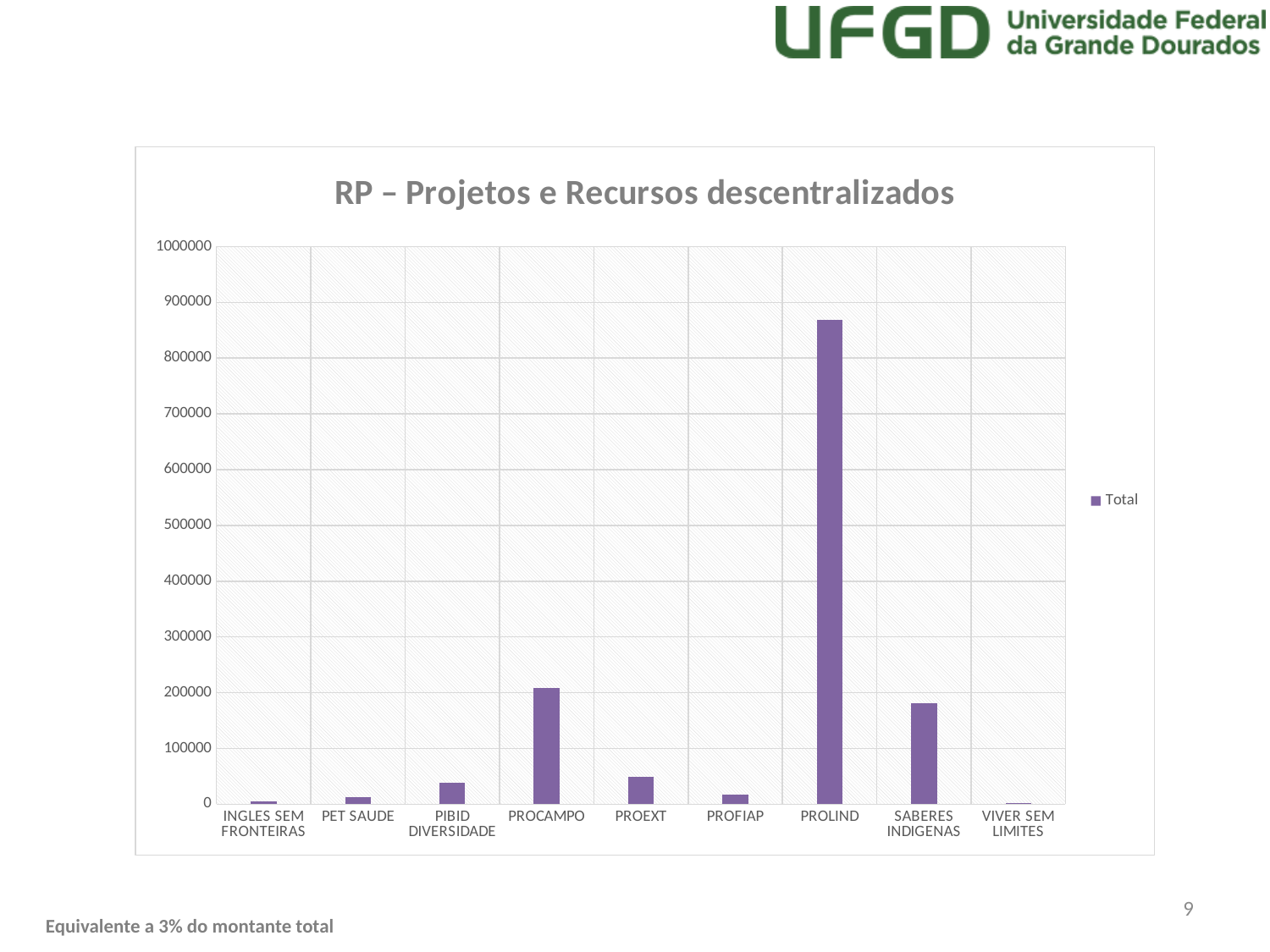
Which category has the highest value? PROLIND Is the value for PROCAMPO greater or less than 100000? greater What kind of chart is shown on the slide? bar chart Is the value for PROEXT greater or less than 100000? less Is the value for SABERES INDIGENAS greater or less than 200000? less Which is larger, the value for PROLIND or the value for PROCAMPO? PROLIND How many categories are shown on the x axis of the chart? 9 What is the title of the chart? RP – Projetos e Recursos descentralizados Which is larger, the value for PROCAMPO or the value for SABERES INDIGENAS? PROCAMPO What is the name of the series shown in the legend? Total How many series does the legend list? 1